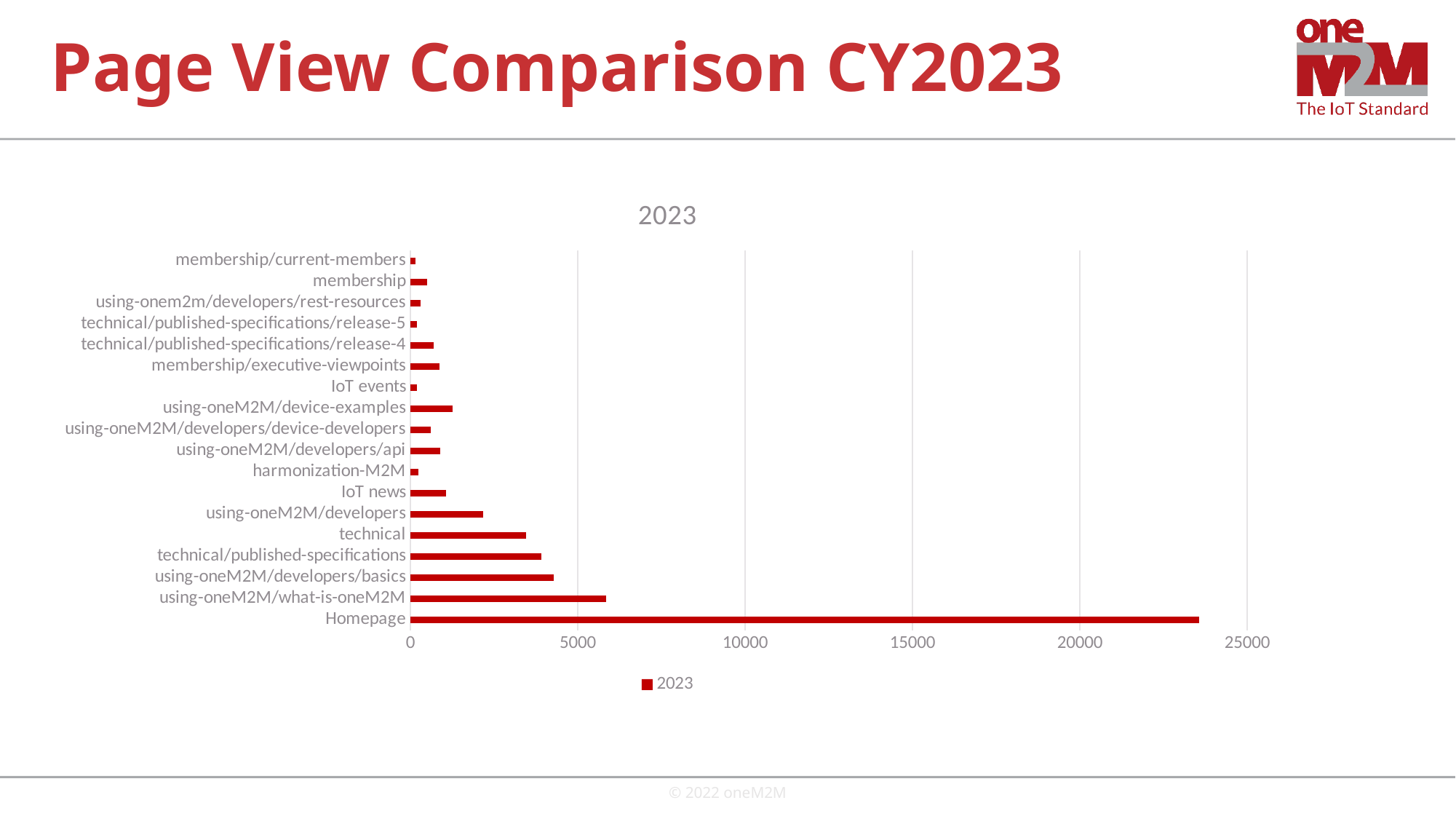
Which has more page views, using-oneM2M/device-examples or IoT events? using-oneM2M/device-examples Which has more page views, technical or using-oneM2M/developers? technical What kind of chart is shown on the slide? bar chart Is the value for technical greater or less than 5000? less Is the value for using-oneM2M/what-is-oneM2M greater or less than 5000? greater Which has more page views, Homepage or using-oneM2M/what-is-oneM2M? Homepage How many series does the legend list? 1 Which page has the highest number of page views in the chart? Homepage Is the value for using-oneM2M/developers greater or less than 5000? less What is the title shown above the chart? 2023 How many pages (categories) are listed in the chart? 18